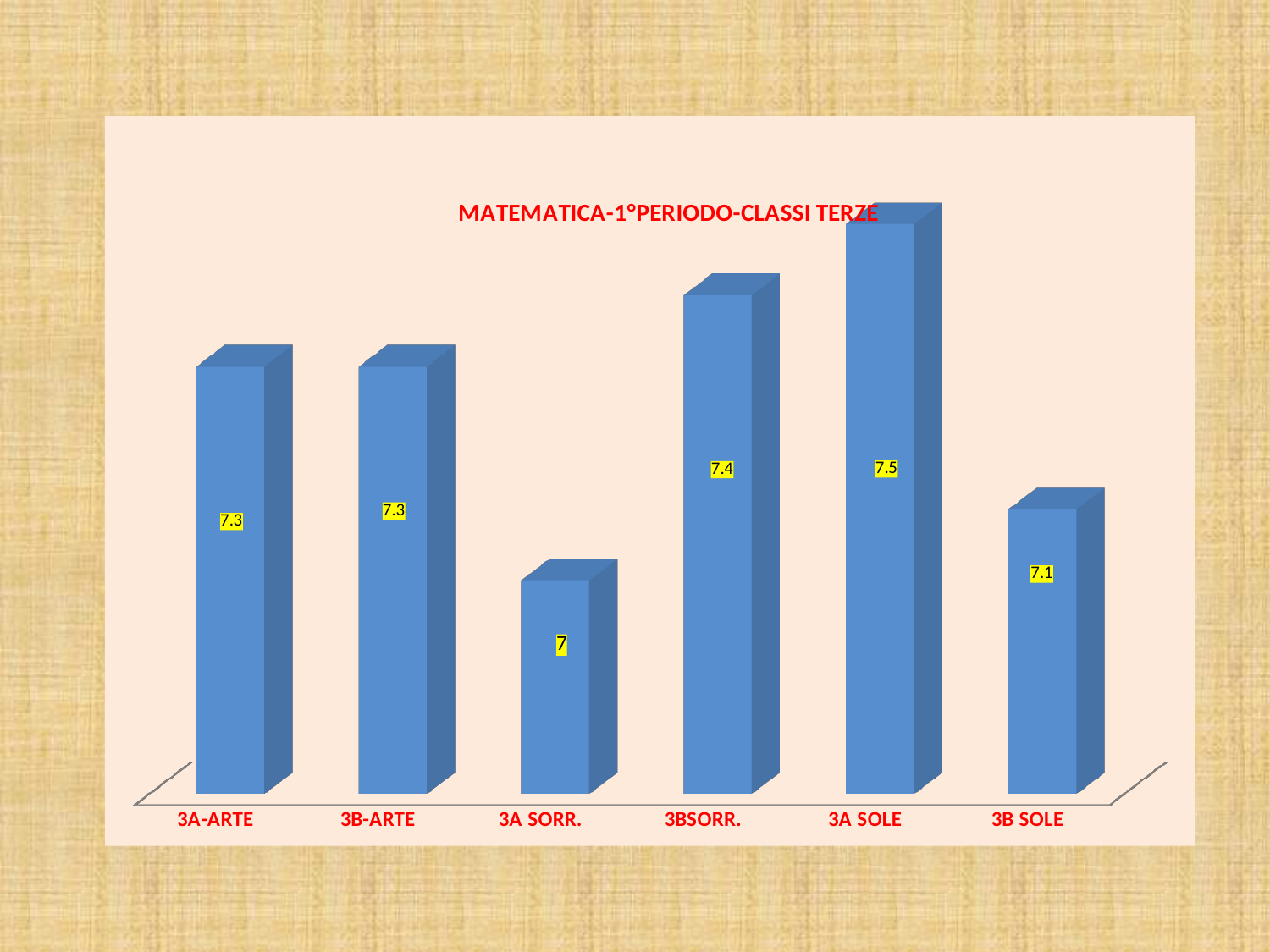
What kind of chart is shown on the slide? bar chart What is the difference between the values for 3BSORR. and 3B SOLE? 0.3 What is the value for 3B SOLE? 7.1 What is the value for 3A-ARTE? 7.3 Which category has the highest value? 3A SOLE What is the difference between the values for 3A SOLE and 3A SORR.? 0.5 What is the value for 3BSORR.? 7.4 How many categories are shown on the chart? 6 Which is larger, the value for 3B-ARTE or the value for 3B SOLE? 3B-ARTE Which category has the lowest value? 3A SORR. What is the title of the chart? MATEMATICA-1°PERIODO-CLASSI TERZE What is the value for 3A SORR.? 7